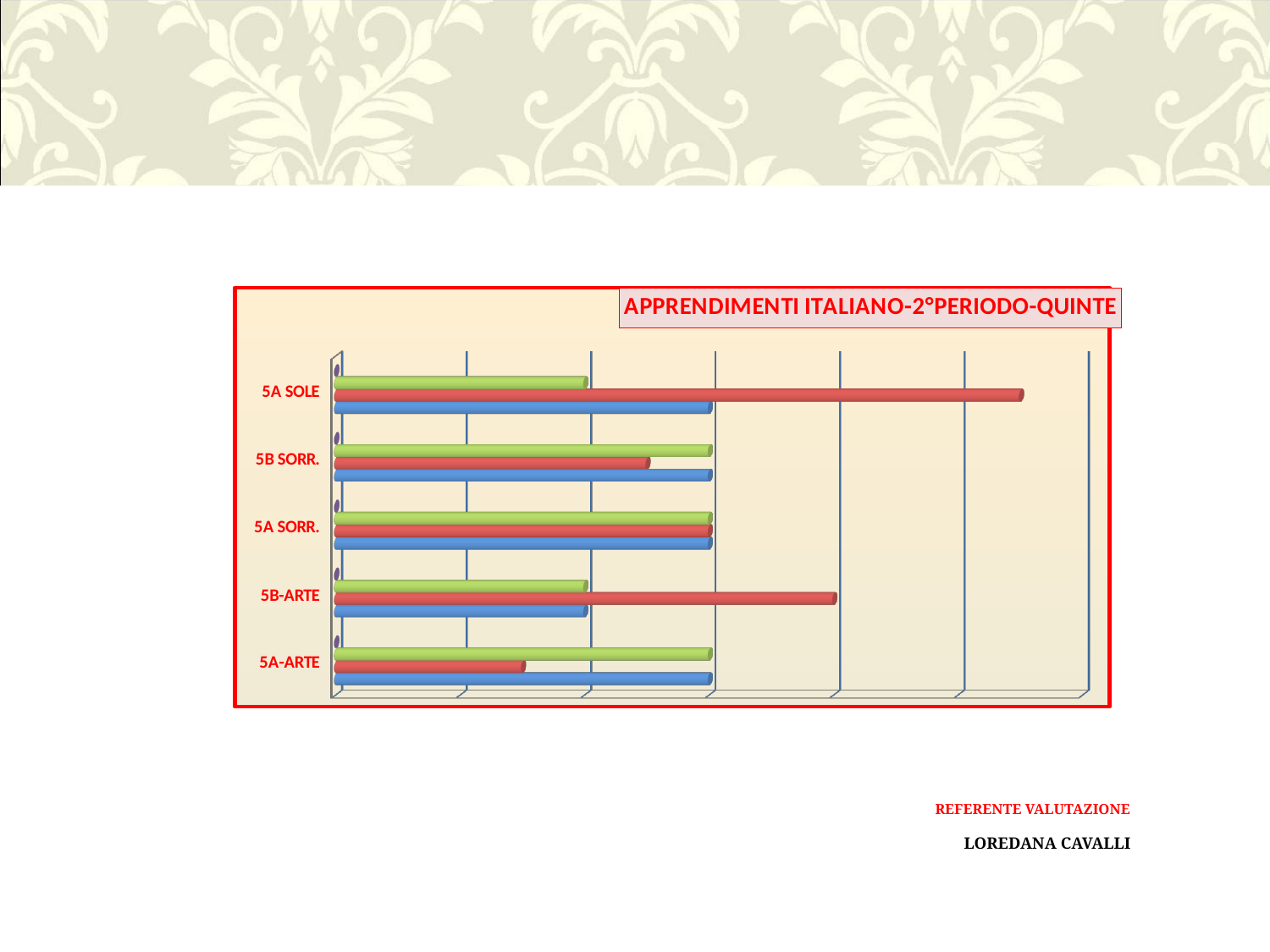
Which category has the longest red bar? 5A SOLE How many categories (classes) are shown on the chart's vertical axis? 5 What type of chart is shown on the slide? bar chart Is the red bar longer for 5B-ARTE or for 5A SOLE? 5A SOLE Which category has the shortest blue bar? 5B-ARTE For 5A SOLE, which bar is longer, the red one or the green one? red How many bars are plotted for each category? 3 What is the title of the chart? APPRENDIMENTI ITALIANO-2°PERIODO-QUINTE Is the green bar longer for 5A SOLE or for 5B SORR.? 5B SORR. What colour is the longest bar on the chart? red Which category has the shortest red bar? 5A-ARTE